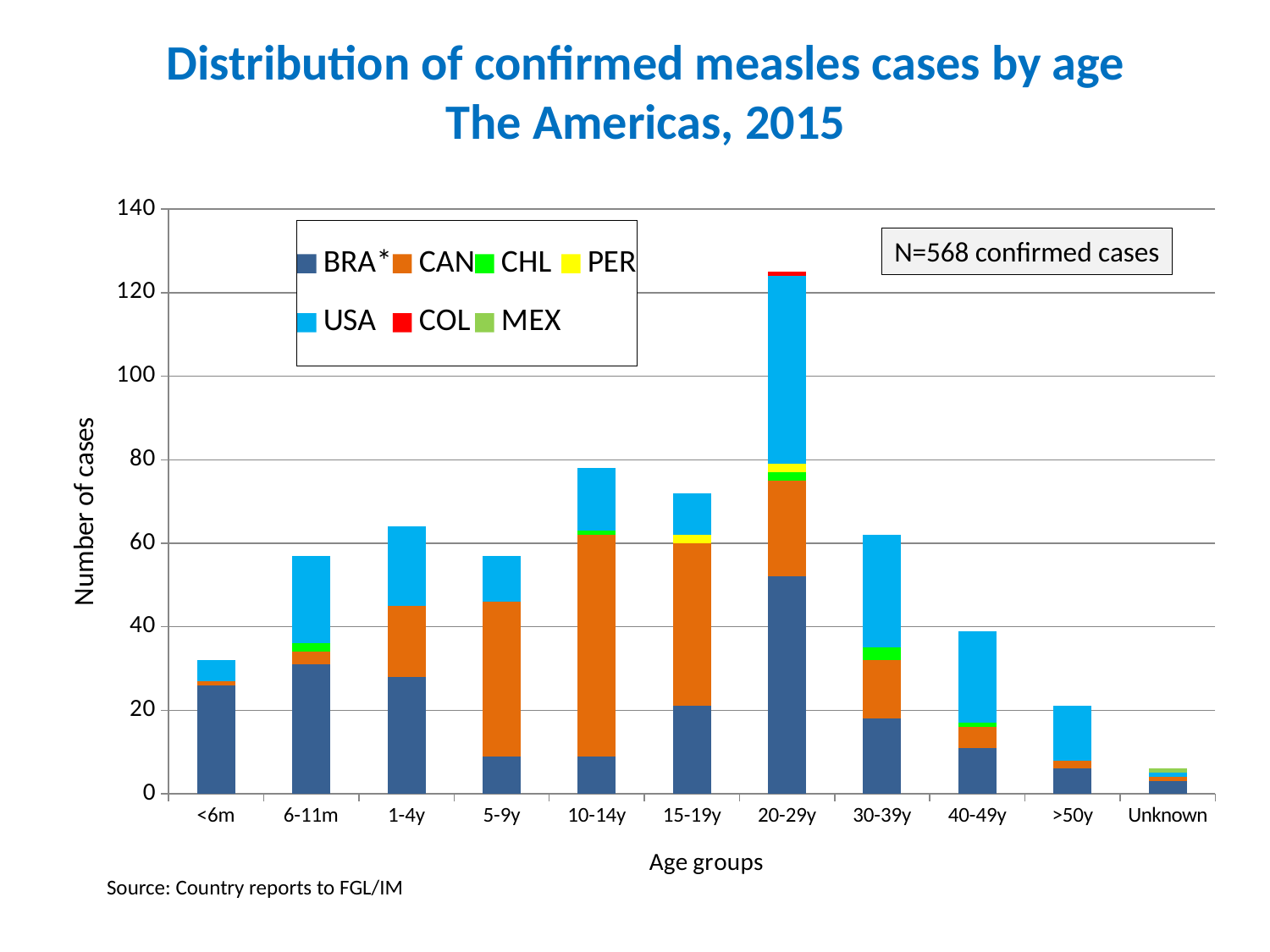
Which age group has a larger total number of cases, 10-14y or 15-19y? 10-14y What kind of chart is shown on the slide? Stacked bar chart Is the total number of cases for the 5-9y age group greater or less than 60? less Is the total number of cases for the <6m age group greater or less than 20? greater How many age group categories are shown on the x axis? 11 Which age group has a larger total number of cases, 6-11m or 1-4y? 1-4y Is the total number of cases for the 10-14y age group greater or less than 80? less According to the text box on the chart, how many confirmed cases are there in total? N=568 confirmed cases Which age group has the lowest total number of confirmed measles cases? Unknown How many series does the legend list? 7 Which age group has the highest total number of confirmed measles cases? 20-29y